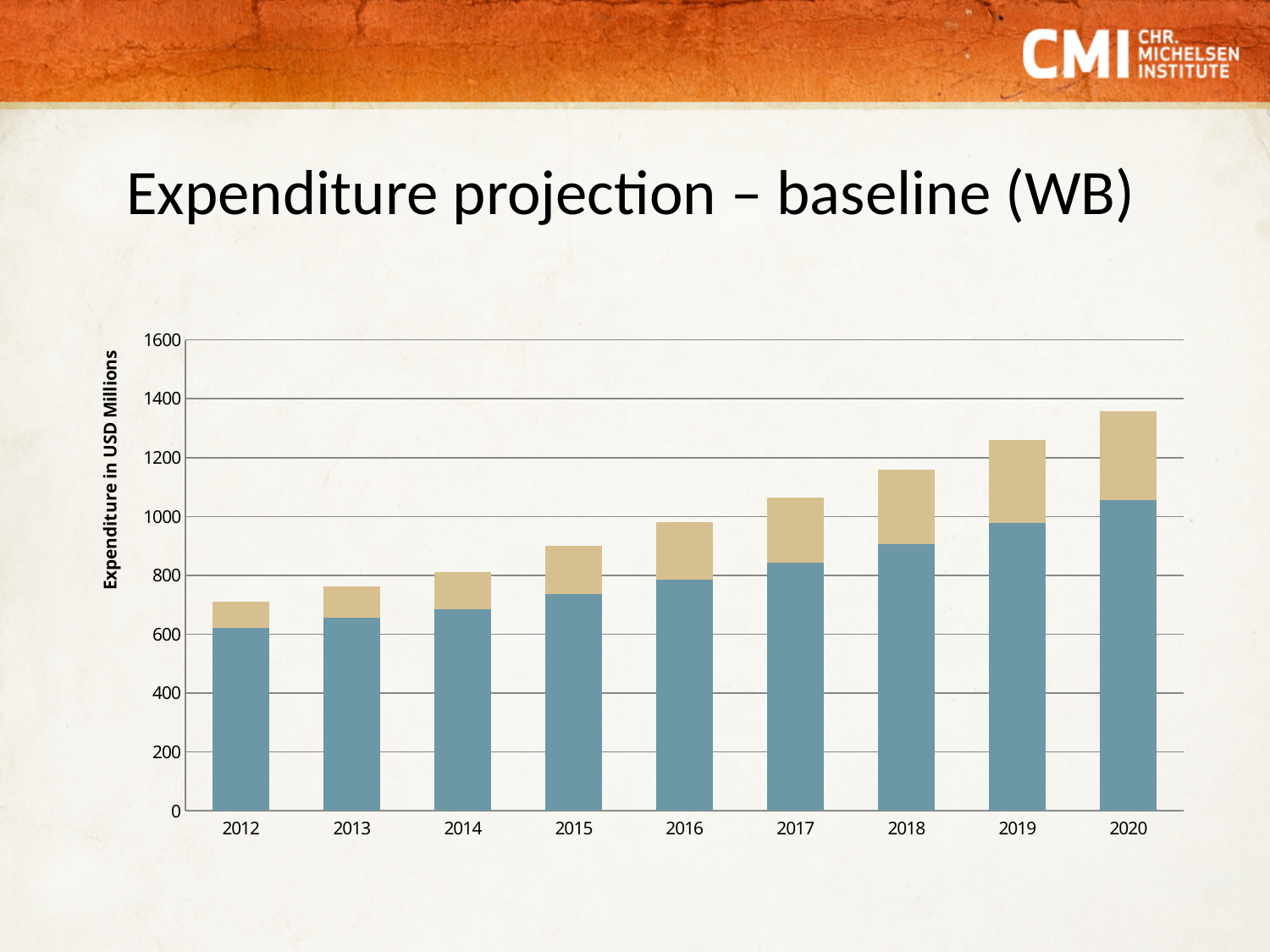
Is the total expenditure for 2016 greater or less than 1000? less Is the total expenditure for 2012 greater or less than 800? less Do the total expenditure values rise or fall from 2012 to 2020? Rise Is the total expenditure for 2020 greater or less than 1200? greater How many years are shown on the x axis of the chart? 9 What kind of chart is shown on the slide? Stacked bar chart Which year has the lowest total expenditure in the chart? 2012 Which year has the larger total expenditure, 2013 or 2019? 2019 What is the title of the slide's chart? Expenditure projection – baseline (WB) Which year has the highest total expenditure in the chart? 2020 What is the label on the vertical axis of the chart? Expenditure in USD Millions